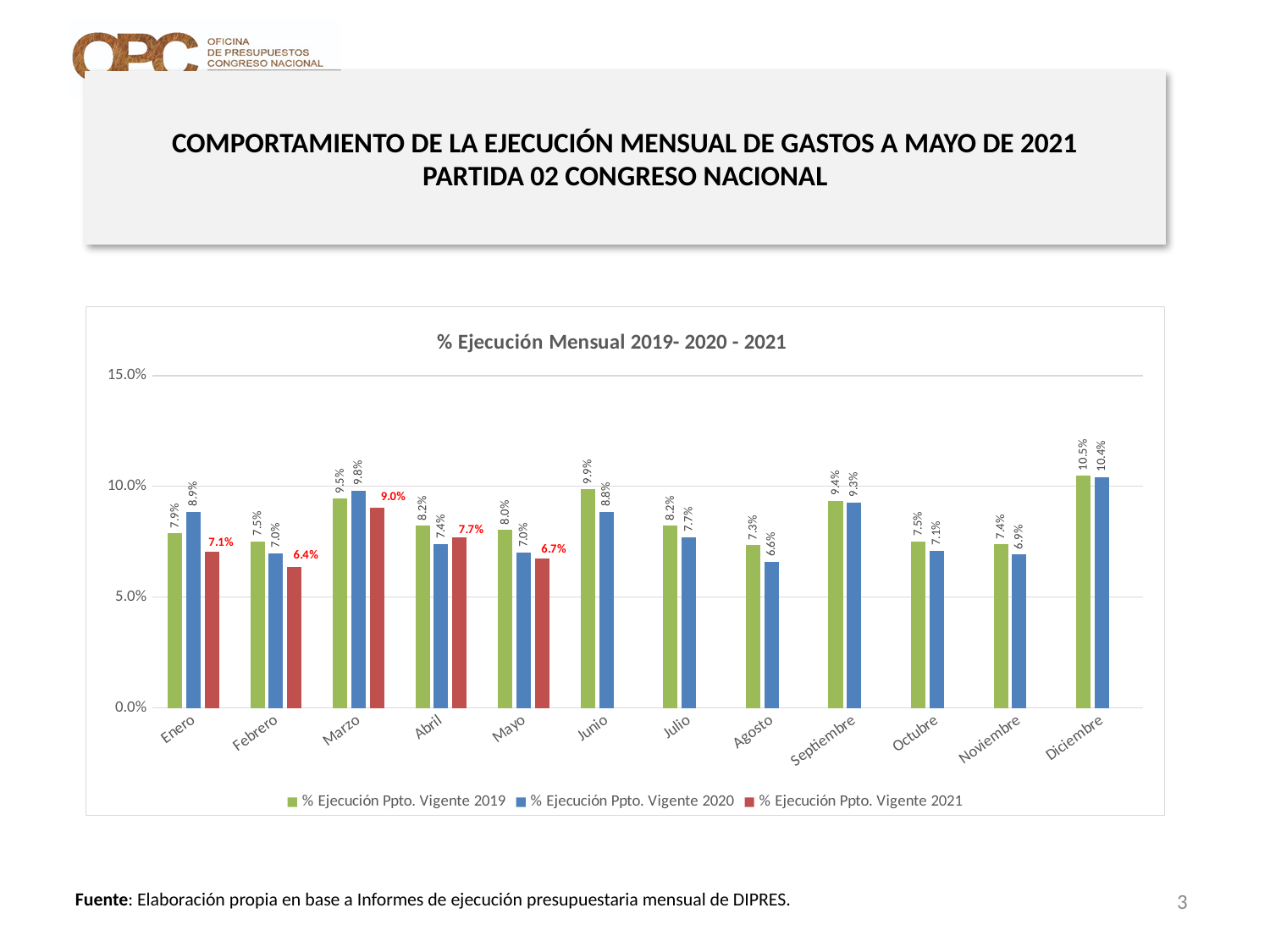
What is the value for % Ejecución Ppto. Vigente 2021 in Marzo? 9.0% How many months are shown on the x axis? 12 What is the value for % Ejecución Ppto. Vigente 2020 in Agosto? 6.6% What is the title of the chart? % Ejecución Mensual 2019- 2020 - 2021 Which month has the highest value for % Ejecución Ppto. Vigente 2019? Diciembre What kind of chart is shown? Bar chart What is the value for % Ejecución Ppto. Vigente 2019 in Junio? 9.9% Is the value for % Ejecución Ppto. Vigente 2019 in Diciembre greater or less than 10.0%? greater What is the difference between the 2019 and 2020 values in Enero? 1.0% How many series does the legend list? 3 In Abril, which is larger: the 2020 value or the 2021 value? 2021 value Which month has the lowest value for % Ejecución Ppto. Vigente 2021? Febrero